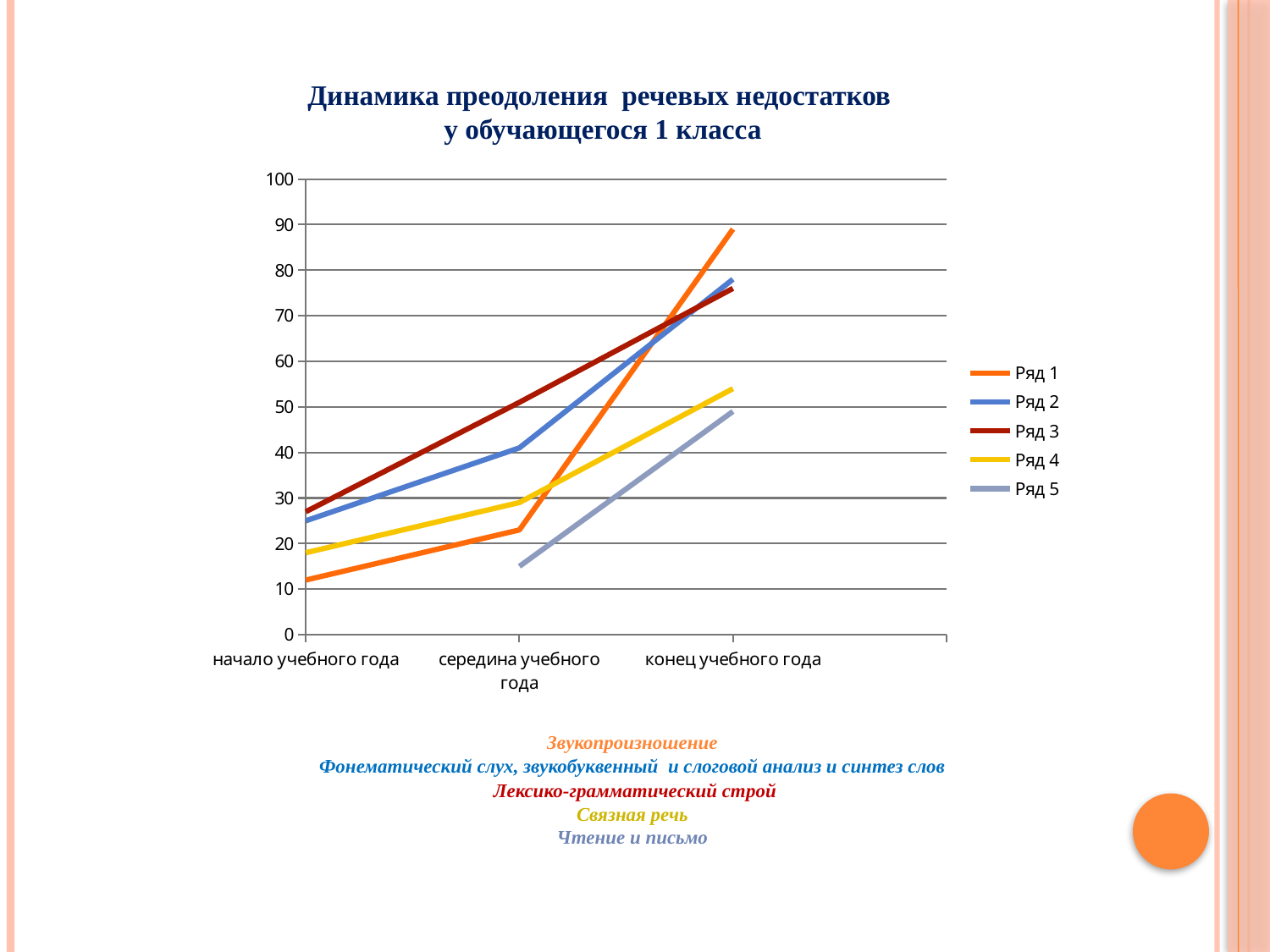
Is the value for Ряд 1 at начало учебного года greater or less than 20? less Does the value for Ряд 1 rise or fall from начало учебного года to конец учебного года? rise Is the value for Ряд 1 at конец учебного года greater or less than 80? greater Which series has the highest value at конец учебного года? Ряд 1 What kind of chart is shown on the slide? line chart At начало учебного года, which is larger: Ряд 3 or Ряд 1? Ряд 3 How many series does the legend list? 5 Is the value for Ряд 5 at середина учебного года greater or less than 20? less How many categories are shown on the x axis? 3 Which series has the lowest value at конец учебного года? Ряд 5 Which series has the lowest value at начало учебного года? Ряд 1 What is the title of the chart? Динамика преодоления речевых недостатков у обучающегося 1 класса